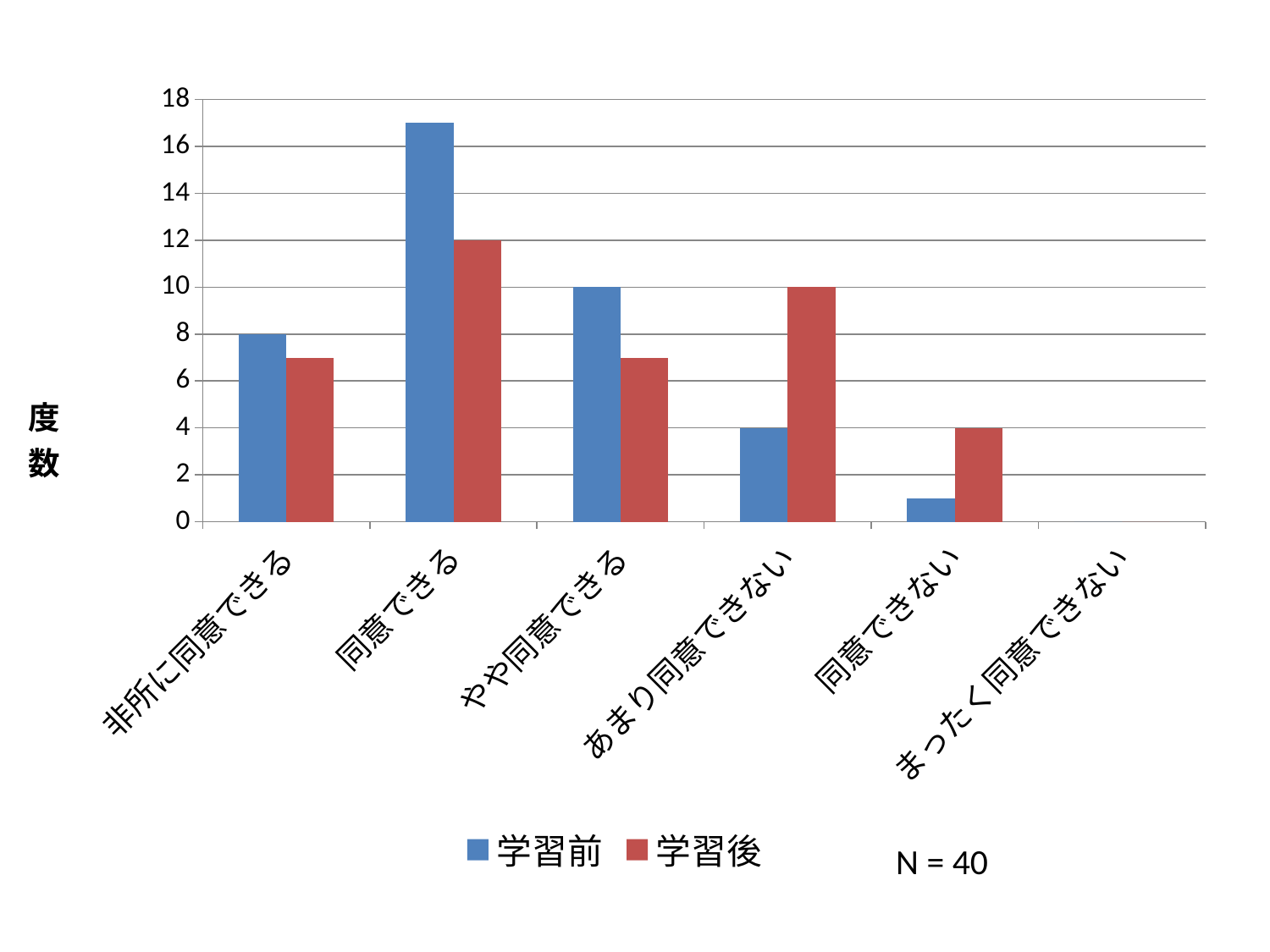
How many categories are shown on the x axis? 6 How many series does the legend list? 2 Is the 学習前 value for 同意できない greater or less than 2? less Is the 学習前 value for 同意できる greater or less than 16? greater What is the difference between the 学習後 values for 同意できる and あまり同意できない? 2 What is the 学習前 value for あまり同意できない? 4 Which category has the highest 学習前 value? 同意できる What kind of chart is shown on the slide? bar chart What is the 学習前 value for やや同意できる? 10 What is the 学習後 value for あまり同意できない? 10 What is the 学習後 value for 同意できる? 12 For あまり同意できない, which series has the larger value, 学習前 or 学習後? 学習後